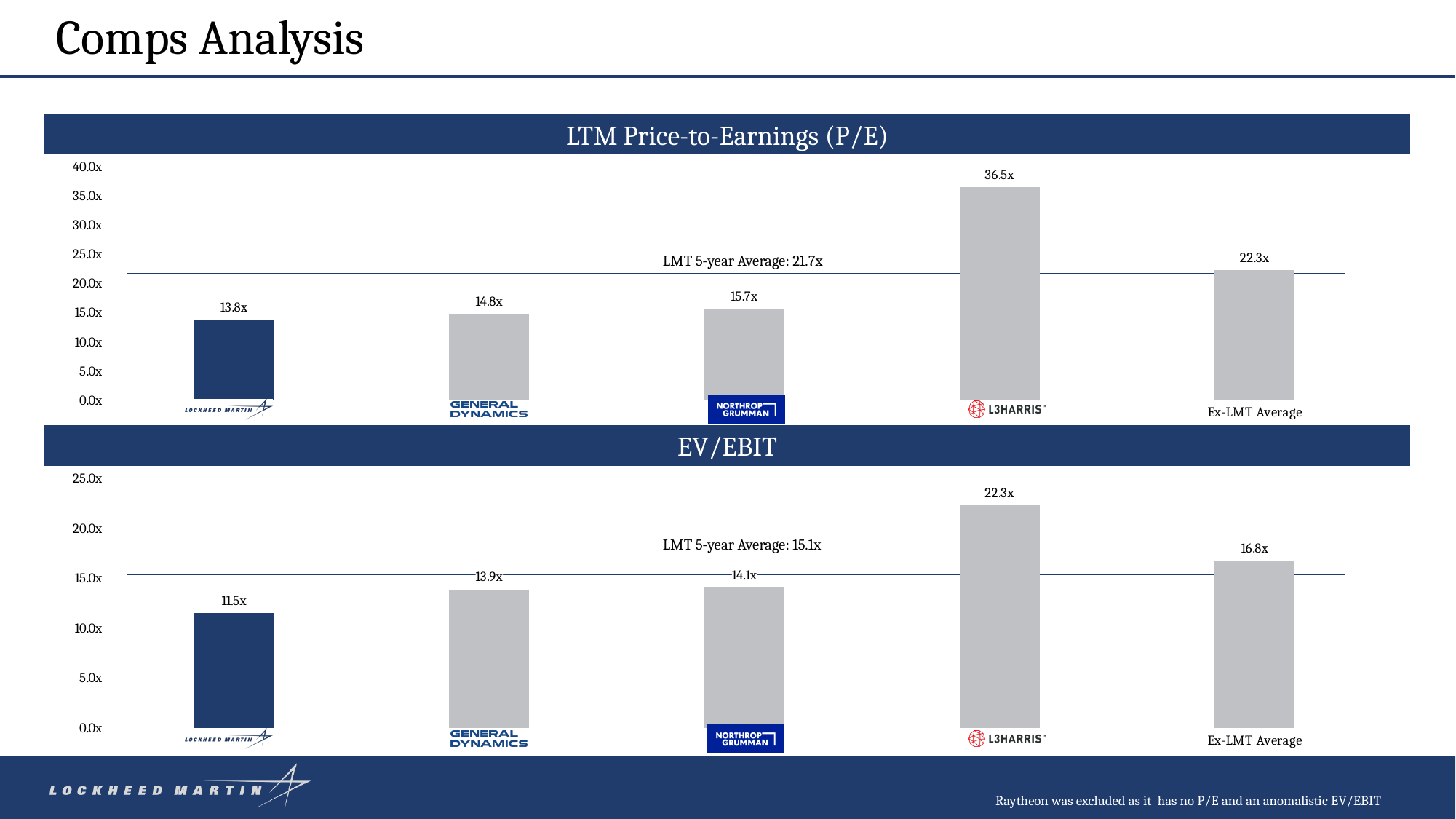
In the EV/EBIT chart, which is larger, General Dynamics or L3Harris? L3Harris In the LTM Price-to-Earnings (P/E) chart, which category has the lowest value? Lockheed Martin In the EV/EBIT chart, what is the difference between L3Harris and Lockheed Martin? 10.8x In the LTM Price-to-Earnings (P/E) chart, what is the value for L3Harris? 36.5x In the EV/EBIT chart, what is the value for the Ex-LMT Average? 16.8x What type of chart is the LTM Price-to-Earnings (P/E) chart? Bar chart In the LTM Price-to-Earnings (P/E) chart, which category has the highest value? L3Harris How many bars are plotted in the EV/EBIT chart? 5 In the LTM Price-to-Earnings (P/E) chart, what is the LMT 5-year Average shown by the horizontal line? 21.7x In the LTM Price-to-Earnings (P/E) chart, what is the value for Lockheed Martin? 13.8x In the EV/EBIT chart, what is the value for Northrop Grumman? 14.1x In the LTM Price-to-Earnings (P/E) chart, what is the difference between the Ex-LMT Average and Lockheed Martin? 8.5x